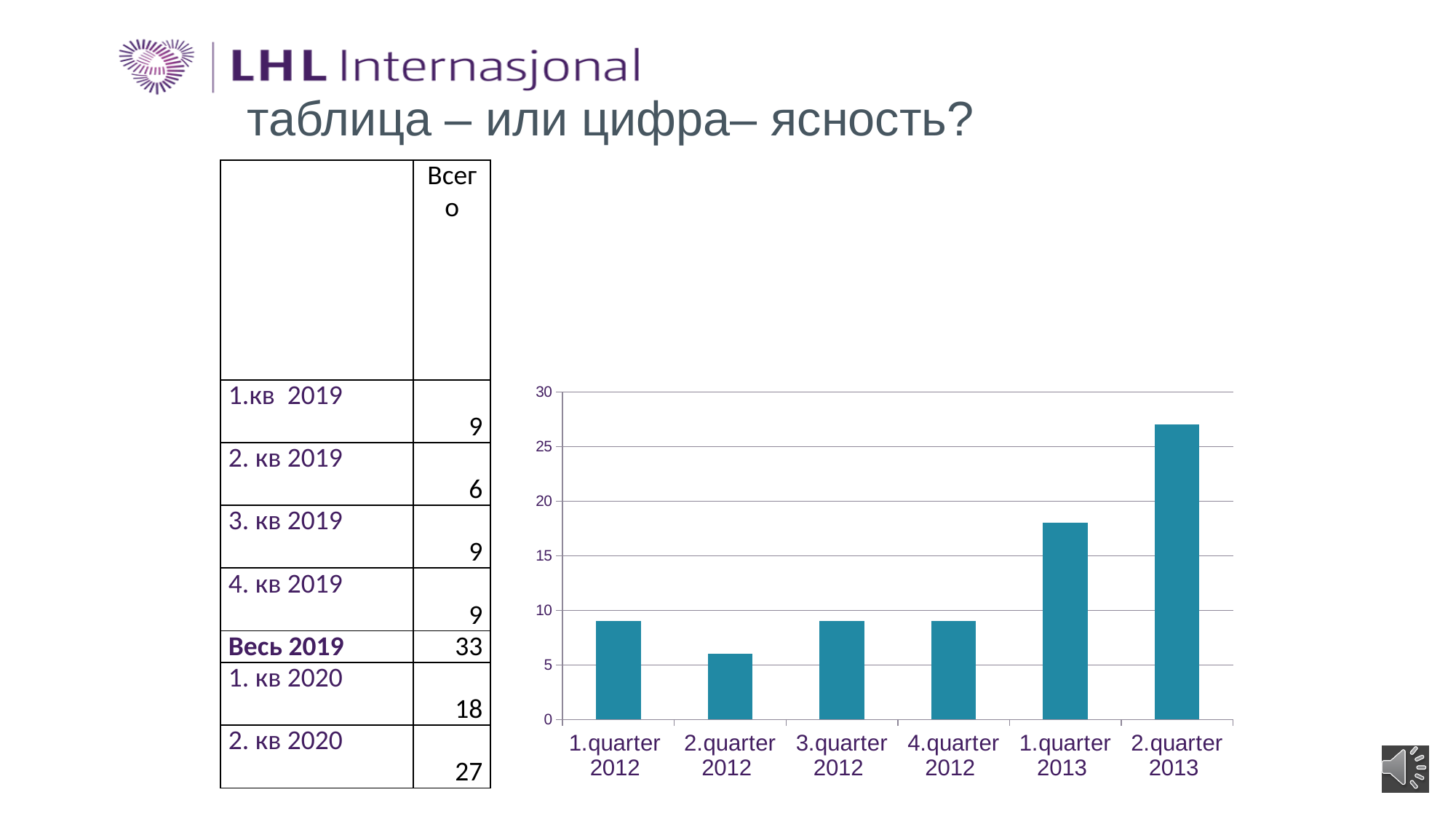
Do the values rise or fall from 4.quarter 2012 to 2.quarter 2013? rise Which category has the lowest bar in the chart? 2.quarter 2012 Which is larger, the value for 1.quarter 2013 or the value for 4.quarter 2012? 1.quarter 2013 Is the value for 1.quarter 2012 greater or less than 10? less What kind of chart is shown on the slide? bar chart Is the value for 2.quarter 2013 greater or less than 25? greater Is the value for 2.quarter 2012 greater or less than 10? less What is the highest value shown on the chart's vertical axis? 30 Which is larger, the value for 3.quarter 2012 or the value for 2.quarter 2012? 3.quarter 2012 Which category has the highest bar in the chart? 2.quarter 2013 How many bars (categories) does the chart show? 6